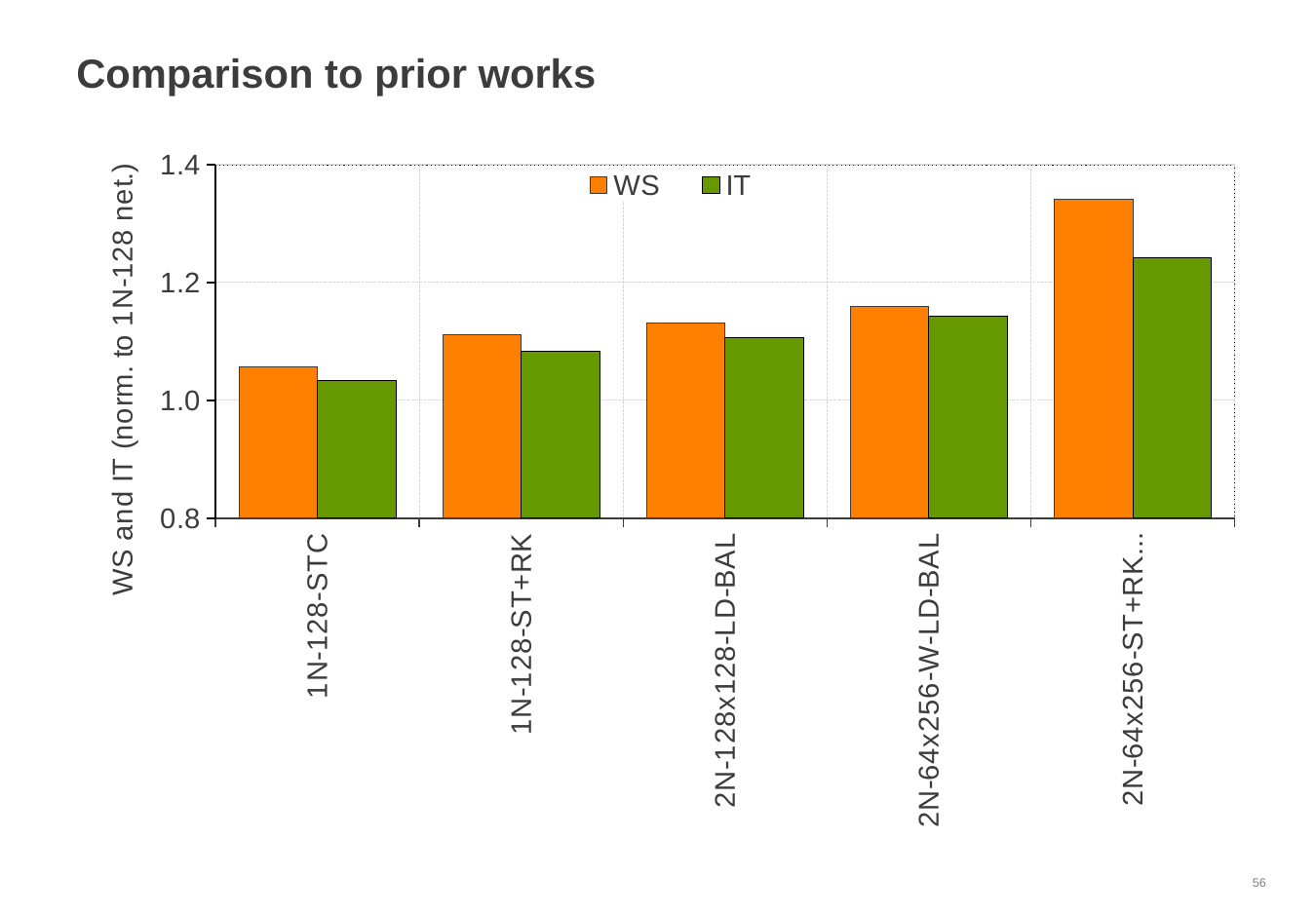
Which is larger, the WS value for 2N-128x128-LD-BAL or the WS value for 1N-128-STC? 2N-128x128-LD-BAL Is the IT value for 1N-128-STC greater or less than 1.2? less How many categories are shown on the x axis? 5 What kind of chart is shown on the slide? bar chart What is the label of the y axis? WS and IT (norm. to 1N-128 net.) Do the WS values rise or fall from left to right along the x axis? rise Which category has the lowest IT value? 1N-128-STC Which category has the highest WS value? 2N-64x256-ST+RK... How many series does the legend list? 2 For 1N-128-STC, which is larger, the WS value or the IT value? WS Is the WS value for 2N-64x256-ST+RK... greater or less than 1.2? greater Is the WS value for 2N-64x256-W-LD-BAL greater or less than 1.2? less